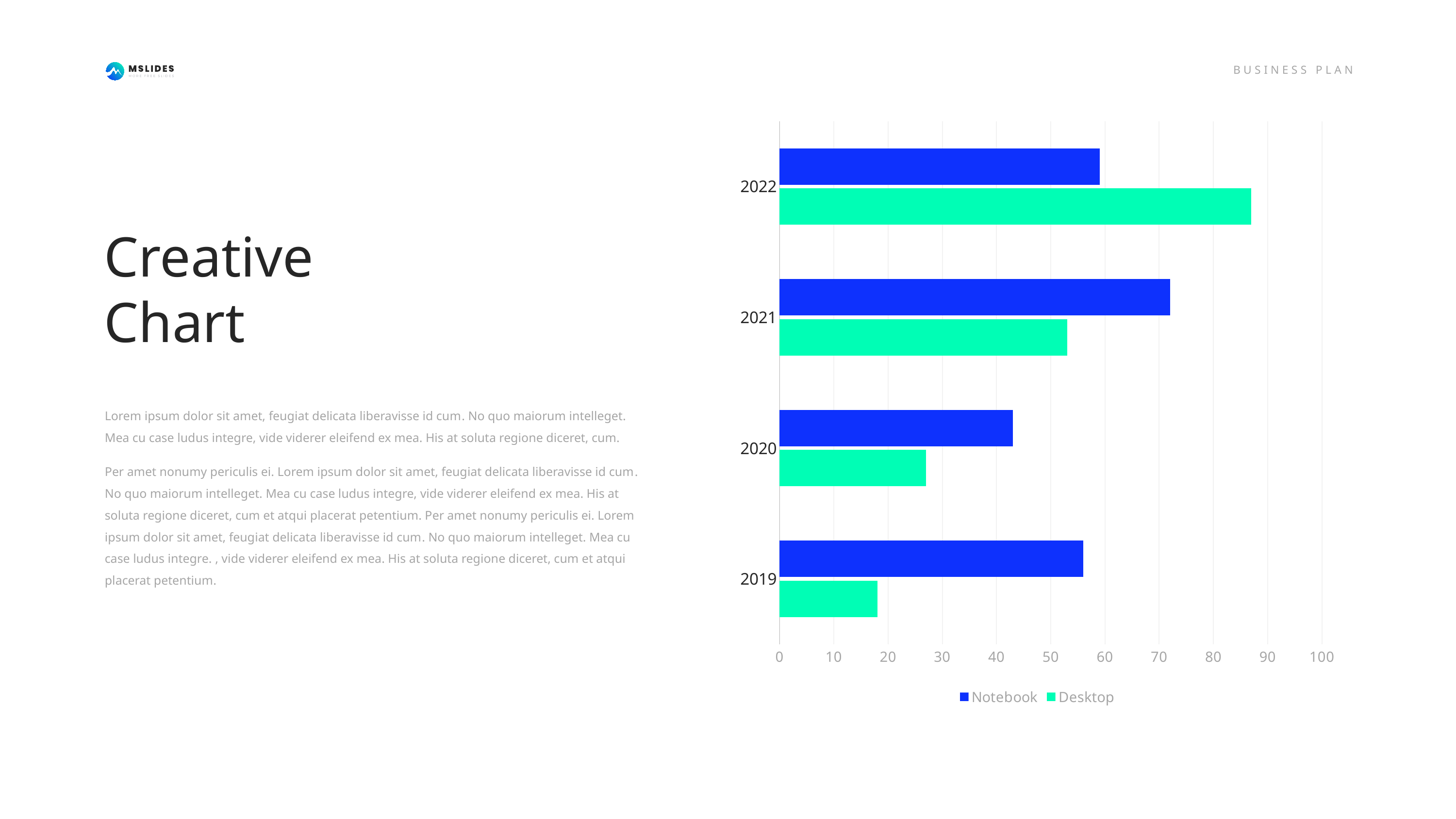
Which series is shown in blue in the chart legend? Notebook How many years are shown on the chart's category axis? 4 In 2022, which is larger, the Notebook value or the Desktop value? Desktop What kind of chart is shown on the slide? bar chart In which year is the Desktop value highest? 2022 In 2021, which is larger, the Notebook value or the Desktop value? Notebook In which year is the Notebook value highest? 2021 Is the Desktop value for 2022 greater or less than 80? greater How many series does the chart legend list? 2 Is the Desktop value for 2019 greater or less than 30? less In which year is the Notebook value lowest? 2020 In which year is the Desktop value lowest? 2019